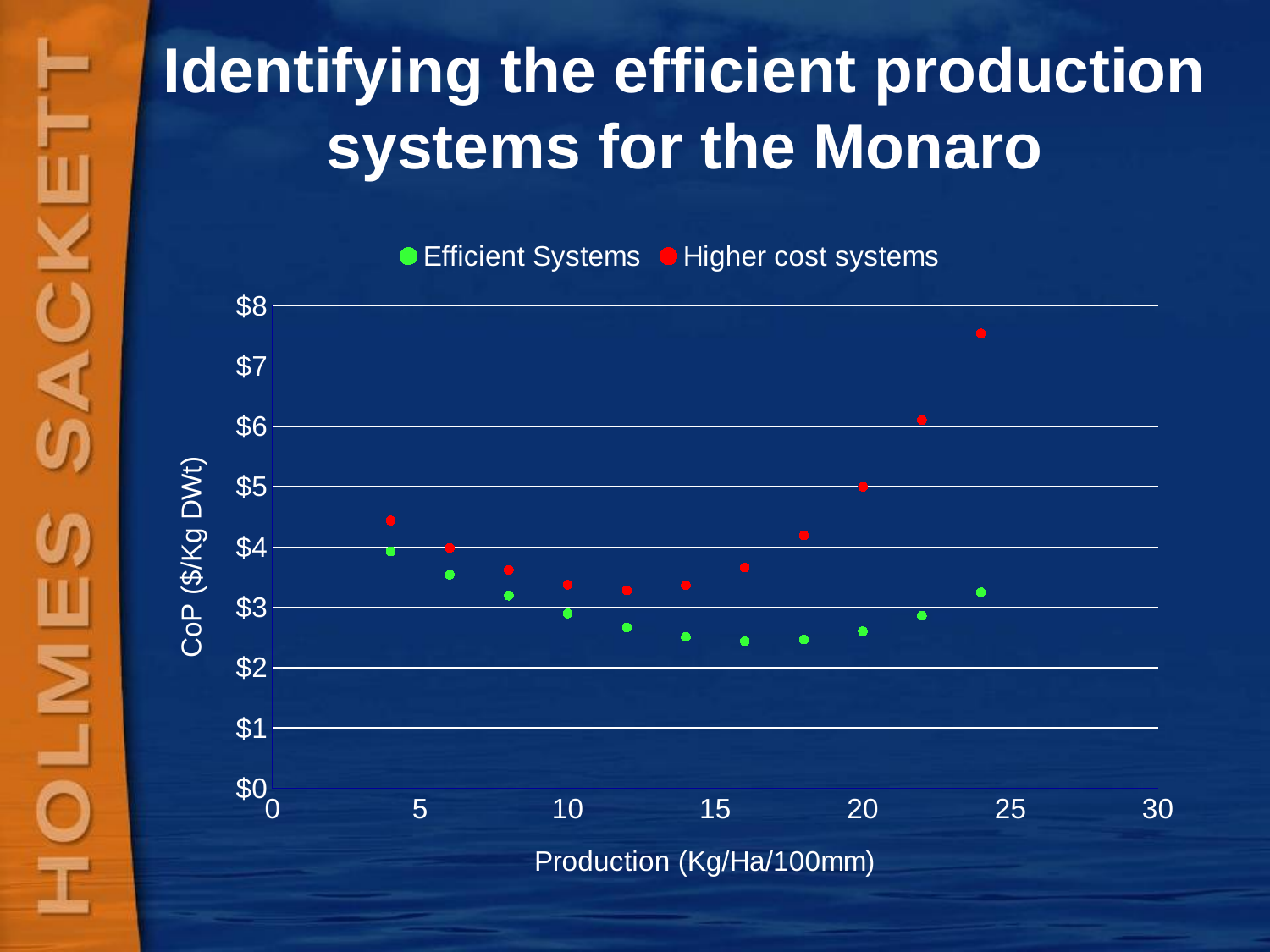
Is the Higher cost systems value at a production of 4 greater or less than $4? greater What are the two series named in the legend? Efficient Systems and Higher cost systems At a production of 20, which series has the higher CoP? Higher cost systems What kind of chart is shown on the slide? scatter chart What is the label of the x axis? Production (Kg/Ha/100mm) At which production level is the Higher cost systems value highest? 24 How many series does the legend list? 2 Is the Higher cost systems value at a production of 24 greater or less than $7? greater Is the Efficient Systems value at a production of 16 greater or less than $3? less How many Efficient Systems (green) points are plotted? 11 Do the Higher cost systems values rise or fall as production increases from 16 to 24? rise At which production level is the Efficient Systems value highest? 4